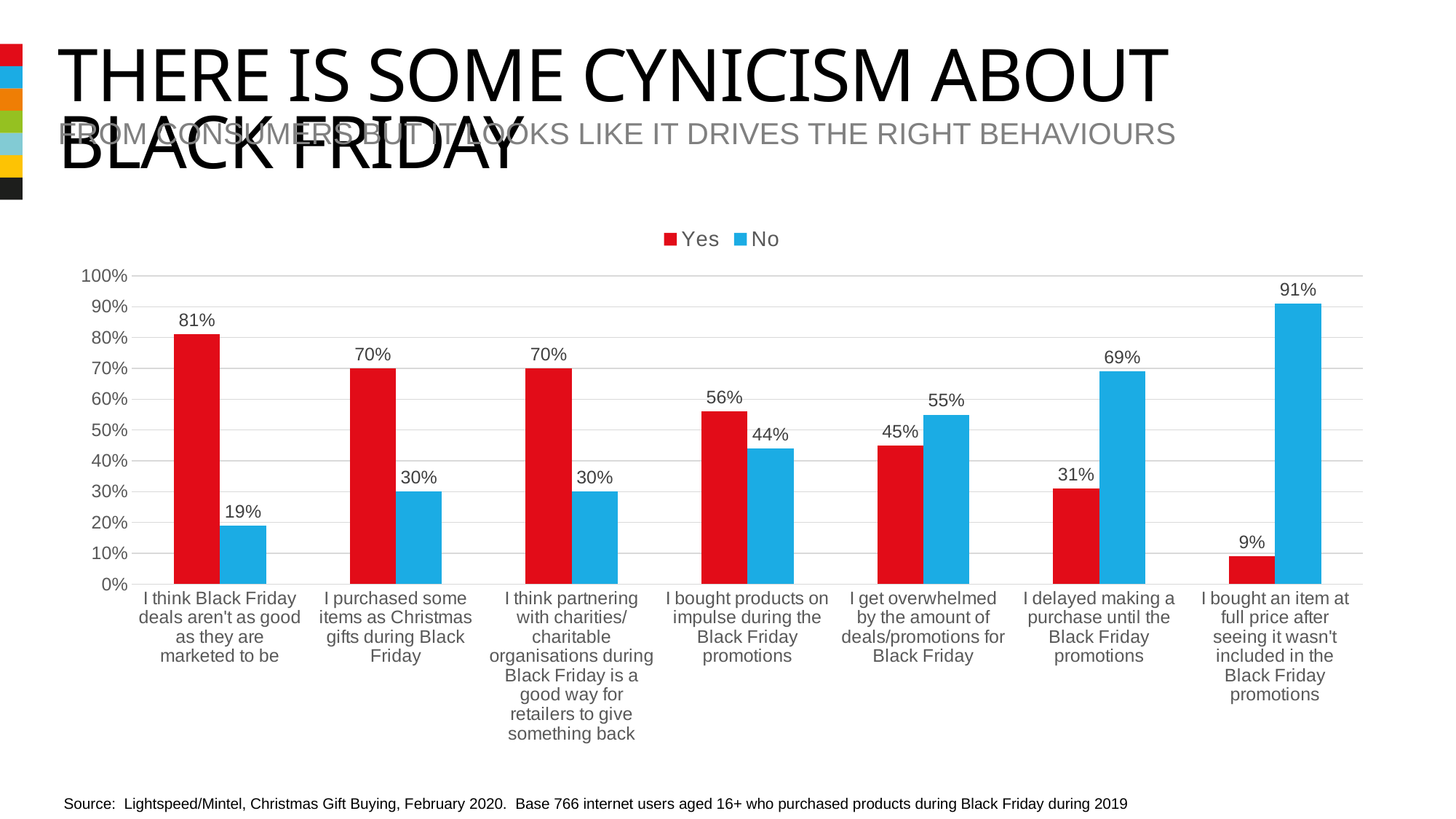
How many statements (categories) are shown on the x axis? 7 Which statement has the lowest Yes percentage? I bought an item at full price after seeing it wasn't included in the Black Friday promotions Which colour represents the Yes series in the chart? Red What percentage answered Yes to "I think Black Friday deals aren't as good as they are marketed to be"? 81% What kind of chart is shown on the slide? Bar chart For "I get overwhelmed by the amount of deals/promotions for Black Friday", which is larger, Yes or No? No Is the No value for "I purchased some items as Christmas gifts during Black Friday" greater or less than 40%? less Which statement has the highest Yes percentage? I think Black Friday deals aren't as good as they are marketed to be How many series does the legend list? 2 What percentage answered No to "I bought an item at full price after seeing it wasn't included in the Black Friday promotions"? 91% What is the Yes value for "I delayed making a purchase until the Black Friday promotions"? 31% What is the difference between the Yes and No values for "I bought products on impulse during the Black Friday promotions"? 12%